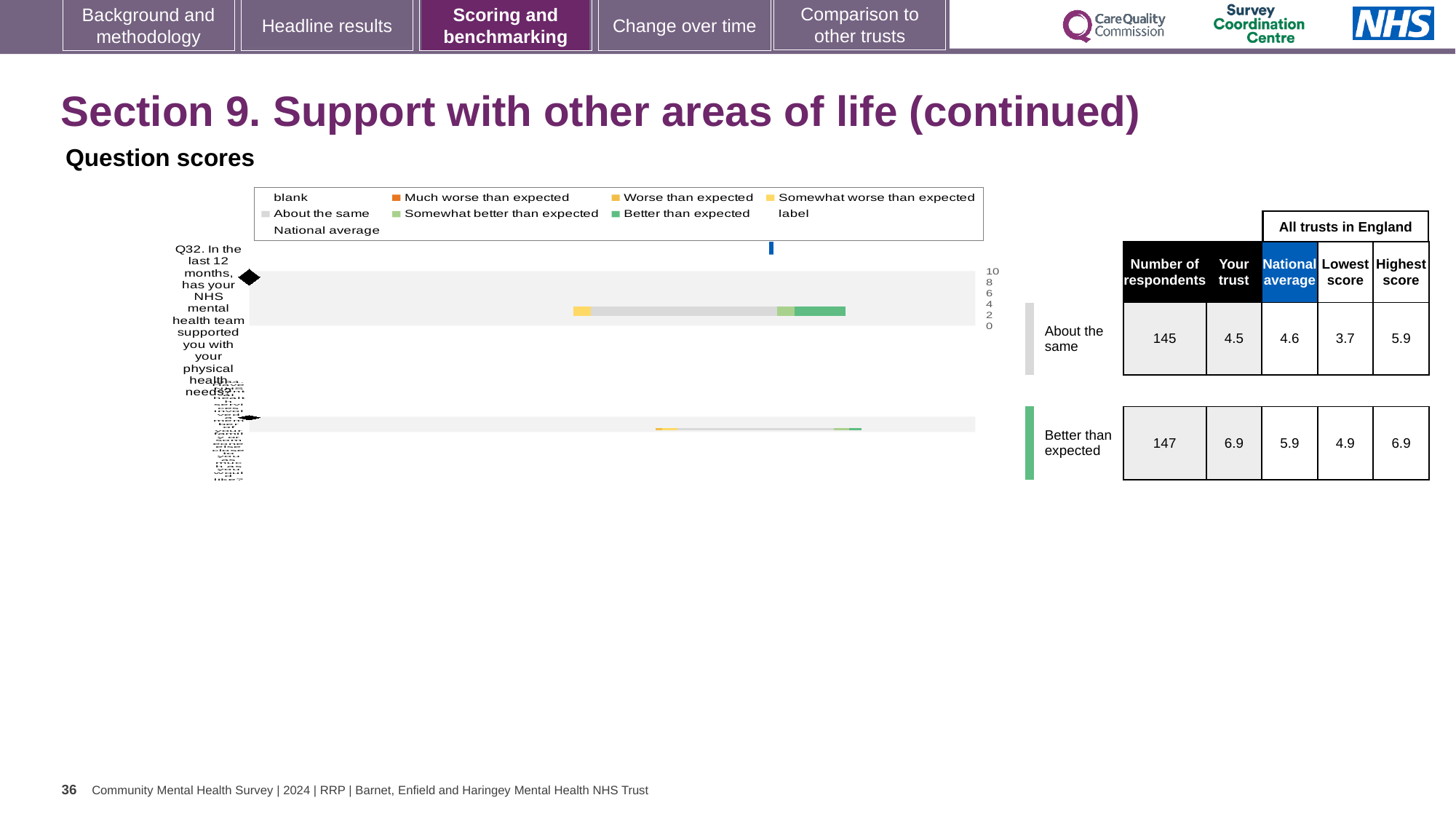
What kind of chart is shown on the slide? bar chart What colour does the legend use for 'Better than expected'? green How many respondents answered Q32? 145 How many questions (bars) are plotted in the chart? 2 What is the difference between the highest and lowest scores for Q32? 2.2 What is the 'Your trust' score for Q32 (support with physical health needs)? 4.5 What is the national average score for Q32? 4.6 What benchmark category is given for Q32? About the same For Q32, which is larger: the 'Your trust' score or the national average? National average What is the lowest score among all trusts in England for Q32? 3.7 What is the highest score among all trusts in England for Q32? 5.9